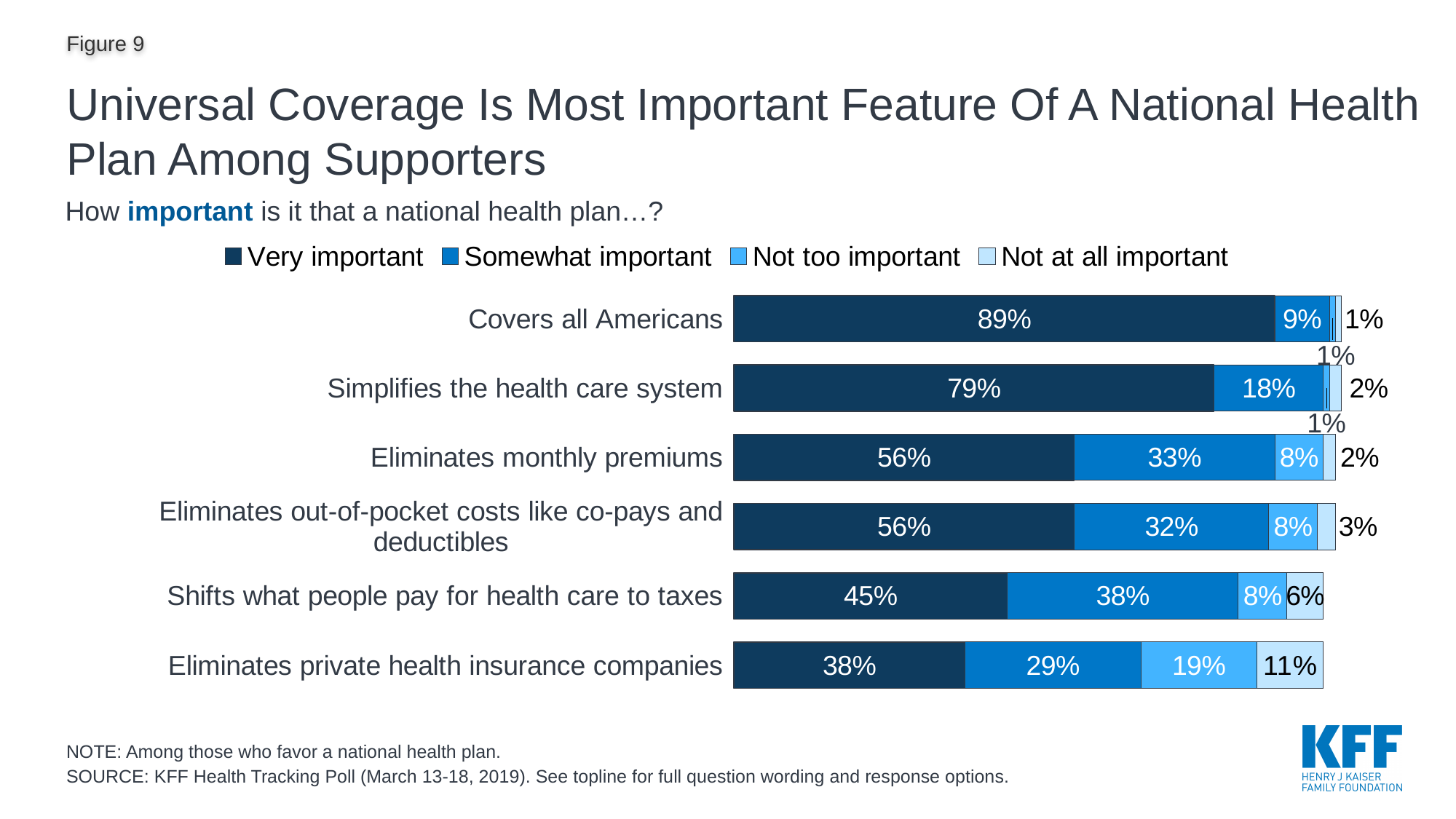
What is the 'Not too important' value for 'Eliminates private health insurance companies'? 19% Which feature has the lowest 'Very important' share? Eliminates private health insurance companies What is the difference in 'Very important' share between 'Covers all Americans' and 'Eliminates private health insurance companies'? 51 percentage points What is the 'Somewhat important' value for 'Eliminates out-of-pocket costs like co-pays and deductibles'? 32% What is the 'Somewhat important' value for 'Simplifies the health care system'? 18% Which has a larger 'Somewhat important' share: 'Shifts what people pay for health care to taxes' or 'Eliminates monthly premiums'? Shifts what people pay for health care to taxes Which feature has the highest 'Very important' share? Covers all Americans What is the 'Not at all important' value for 'Shifts what people pay for health care to taxes'? 6% How many response categories does the legend list? 4 How many features (categories) are shown in the chart? 6 What percentage of supporters say it is very important that a national health plan covers all Americans? 89% Which feature has the highest 'Not at all important' share? Eliminates private health insurance companies